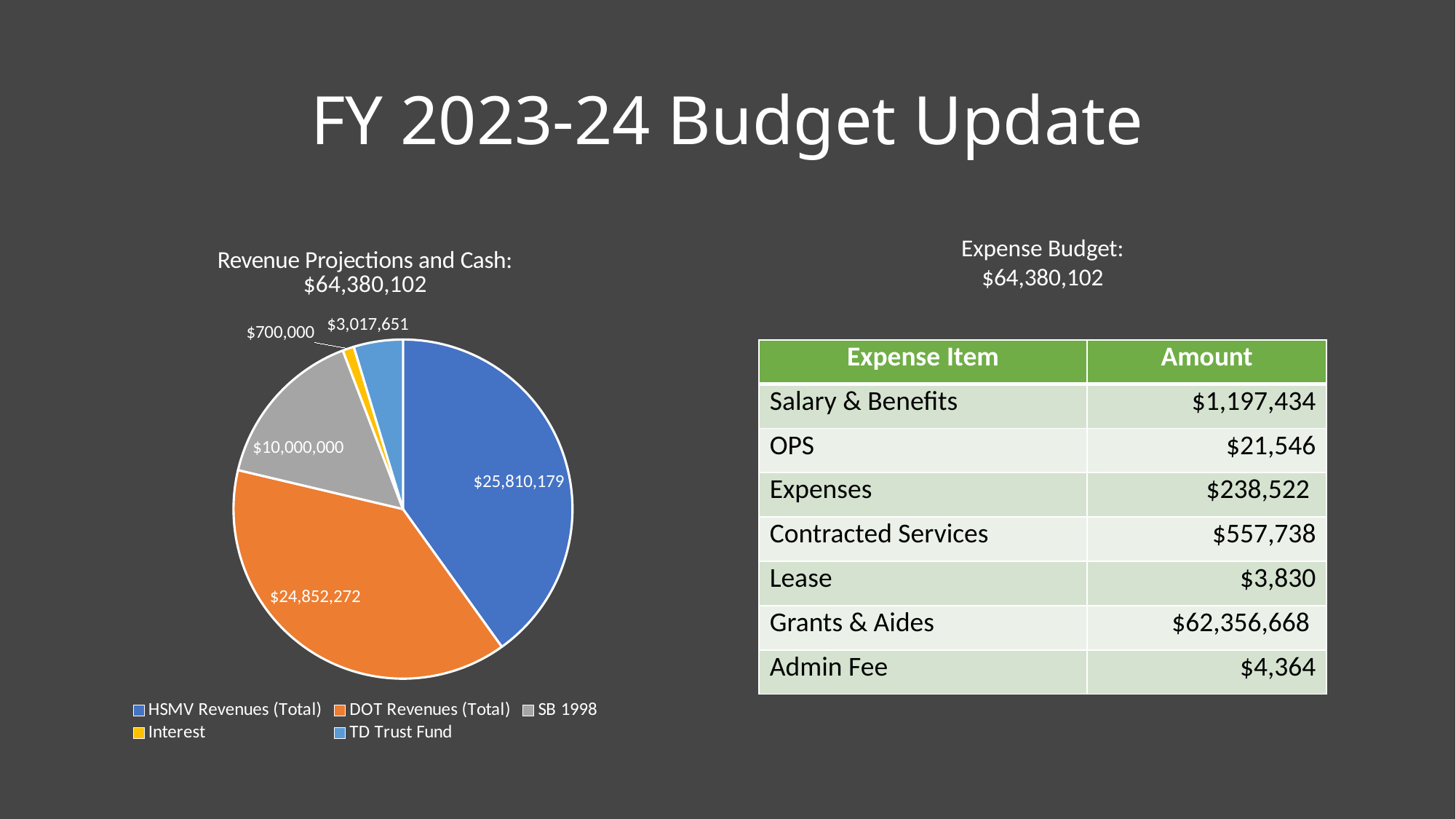
What is the value of the SB 1998 slice in the pie chart? $10,000,000 How many slices does the pie chart have? 5 Which category has the smallest slice in the pie chart? Interest Which is larger in the pie chart, SB 1998 or TD Trust Fund? SB 1998 What is the total shown in the pie chart's title? $64,380,102 Which category is shown in orange in the pie chart? DOT Revenues (Total) What is the difference between the TD Trust Fund and Interest values in the pie chart? $2,317,651 What is the value of the TD Trust Fund slice in the pie chart? $3,017,651 What kind of chart is shown on the slide? Pie chart Which category has the largest slice in the pie chart? HSMV Revenues (Total) What is the value of the HSMV Revenues (Total) slice in the pie chart? $25,810,179 What is the difference between the HSMV Revenues (Total) and DOT Revenues (Total) values in the pie chart? $957,907